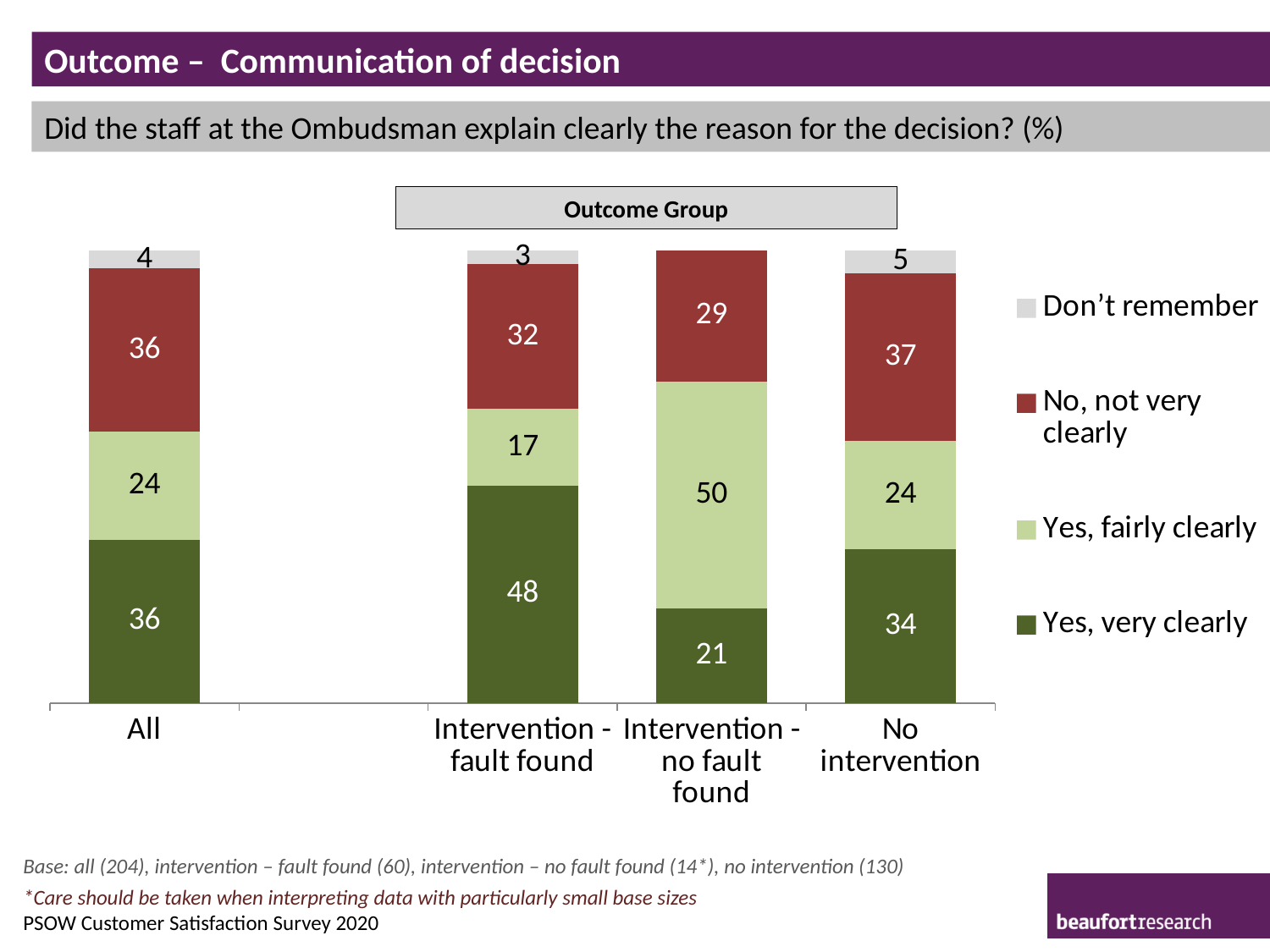
What is the value for 'Yes, fairly clearly' in the 'Intervention - no fault found' bar? 50 What is the value for 'Yes, very clearly' in the 'Intervention - fault found' bar? 48 What is the value for 'No, not very clearly' in the 'All' bar? 36 Which is larger: the 'Yes, fairly clearly' value for 'Intervention - no fault found' or for 'No intervention'? Intervention - no fault found Which category has the lowest value for 'Yes, very clearly'? Intervention - no fault found How many series does the legend list? 4 What kind of chart is shown on the slide? stacked bar chart What is the difference between the 'Yes, very clearly' values for 'Intervention - fault found' and 'Intervention - no fault found'? 27 How many outcome categories are shown on the x axis? 4 What is the value for 'Don't remember' in the 'No intervention' bar? 5 Which category has the highest value for 'Yes, very clearly'? Intervention - fault found What is the total of the stacked bar for 'All'? 100